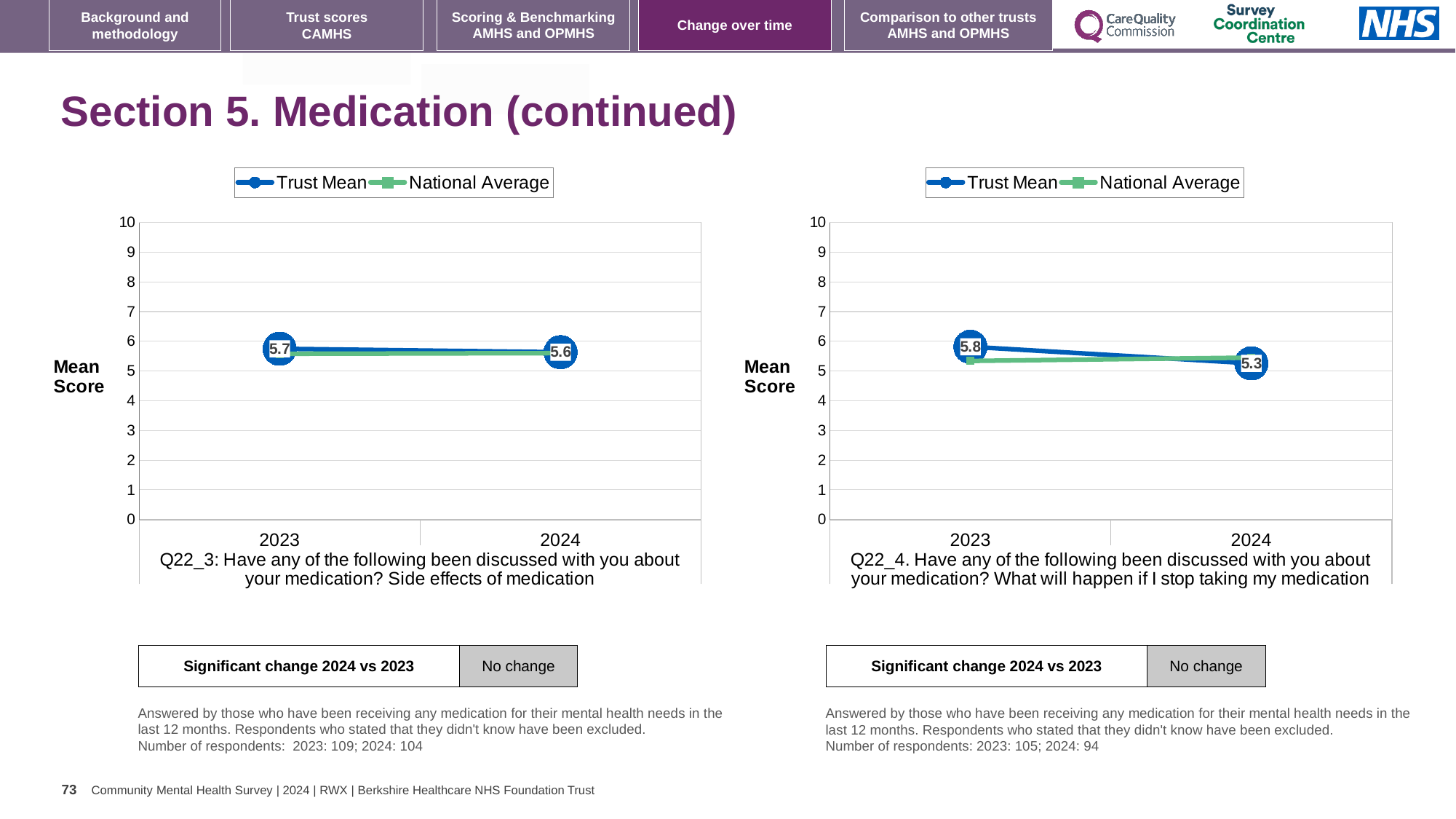
How many series does the legend of the right chart (Q22_4) list? 2 In the right chart (Q22_4), by how much did the Trust Mean change from 2023 to 2024? 0.5 In the right chart (Q22_4), what is the Trust Mean for 2023? 5.8 What kind of chart is the left chart (Q22_3)? line chart In the left chart (Q22_3), by how much did the Trust Mean change from 2023 to 2024? 0.1 In the right chart (Q22_4), does the Trust Mean rise or fall from 2023 to 2024? fall In the left chart (Q22_3), what is the Trust Mean for 2023? 5.7 How many years are shown on the x axis of the left chart (Q22_3)? 2 In the right chart (Q22_4), which year has the higher Trust Mean, 2023 or 2024? 2023 In the left chart (Q22_3), what is the Trust Mean for 2024? 5.6 In the right chart (Q22_4), what is the Trust Mean for 2024? 5.3 In the right chart (Q22_4), is the National Average for 2023 greater or less than 6? less